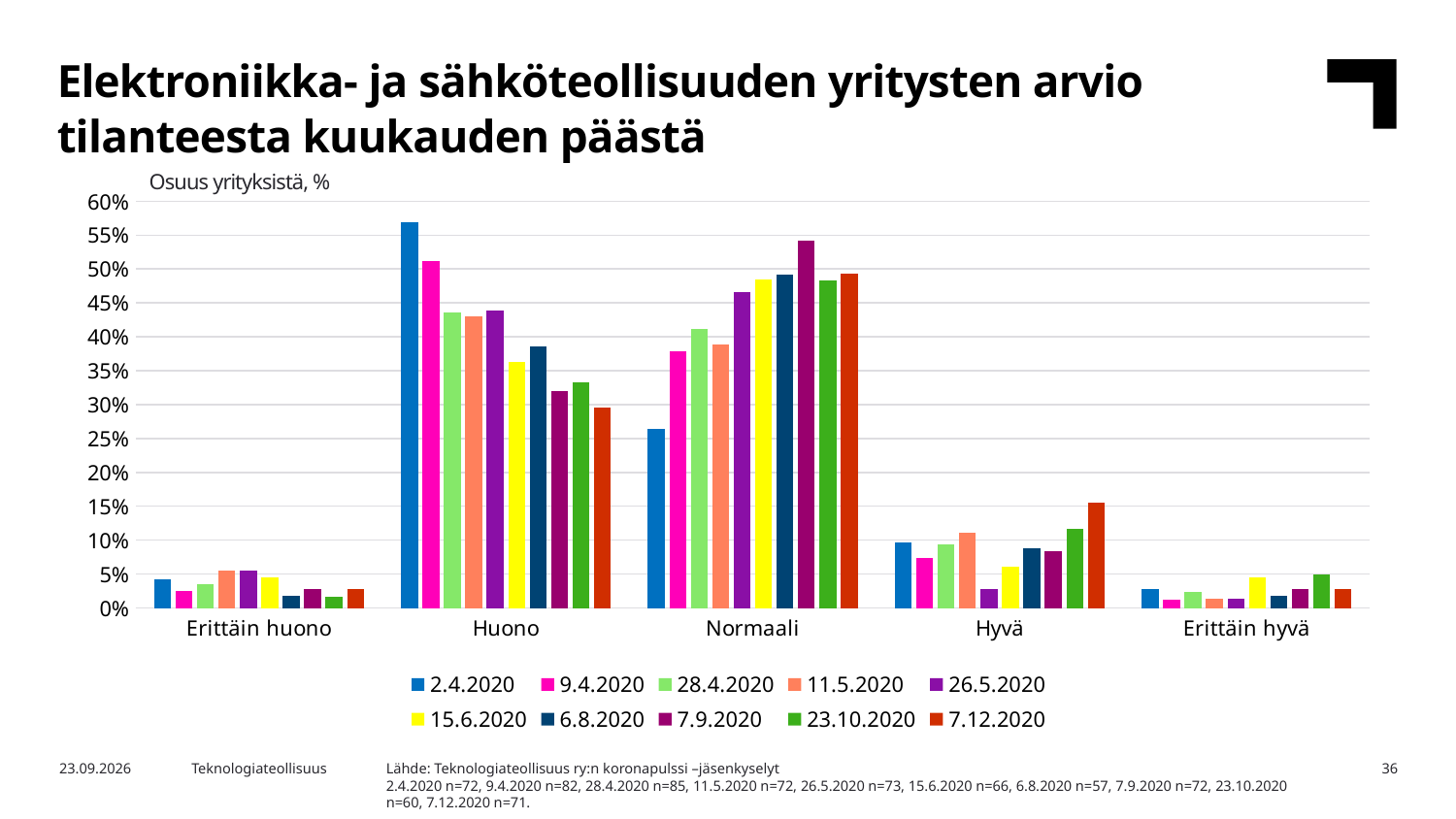
How many series does the legend list? 10 In the Huono category, do the values generally rise or fall from the 2.4.2020 series to the 7.12.2020 series? fall In the Hyvä category, which series has the highest bar? 7.12.2020 Is the value for 2.4.2020 in the Normaali category greater or less than 30%? less Is the value for 7.12.2020 in the Hyvä category greater or less than 10%? greater How many categories are shown on the x axis? 5 In the Normaali category, which series has the highest bar? 7.9.2020 What is the label shown above the vertical axis? Osuus yrityksistä, % For the 2.4.2020 series, which category has the highest bar? Huono What kind of chart is shown on the slide? Bar chart In the Huono category, which is larger: the value for 2.4.2020 or the value for 7.12.2020? 2.4.2020 Is the value for 2.4.2020 in the Huono category greater or less than 50%? greater